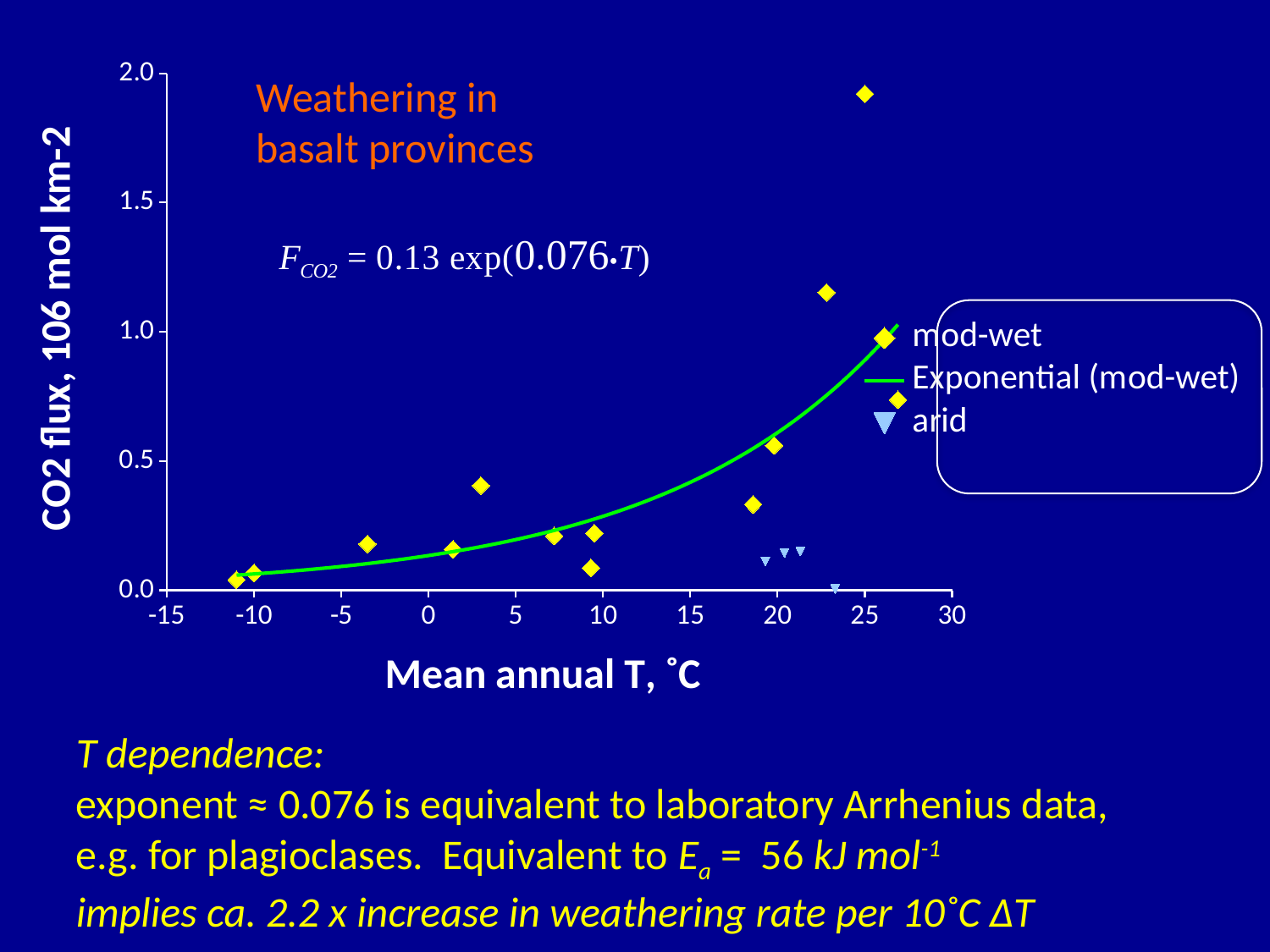
How many series does the chart legend list? 3 What is the maximum value shown on the CO2 flux (y) axis? 2.0 Is the mod-wet data point at about 23 ˚C greater or less than 1.0 on the CO2 flux axis? greater Is the highest mod-wet data point greater or less than 1.5 on the CO2 flux axis? greater At a mean annual temperature of about 20 ˚C, which series has the larger CO2 flux, mod-wet or arid? mod-wet What is the title of the chart's x axis? Mean annual T, ˚C Which series reaches the highest CO2 flux value on the chart, mod-wet or arid? mod-wet Does the CO2 flux for the mod-wet series generally rise or fall as mean annual temperature increases? rise Are all the arid data points greater or less than 0.5 on the CO2 flux axis? less What are the three entries in the chart legend? mod-wet, Exponential (mod-wet), arid What kind of chart is shown on the slide? scatter chart